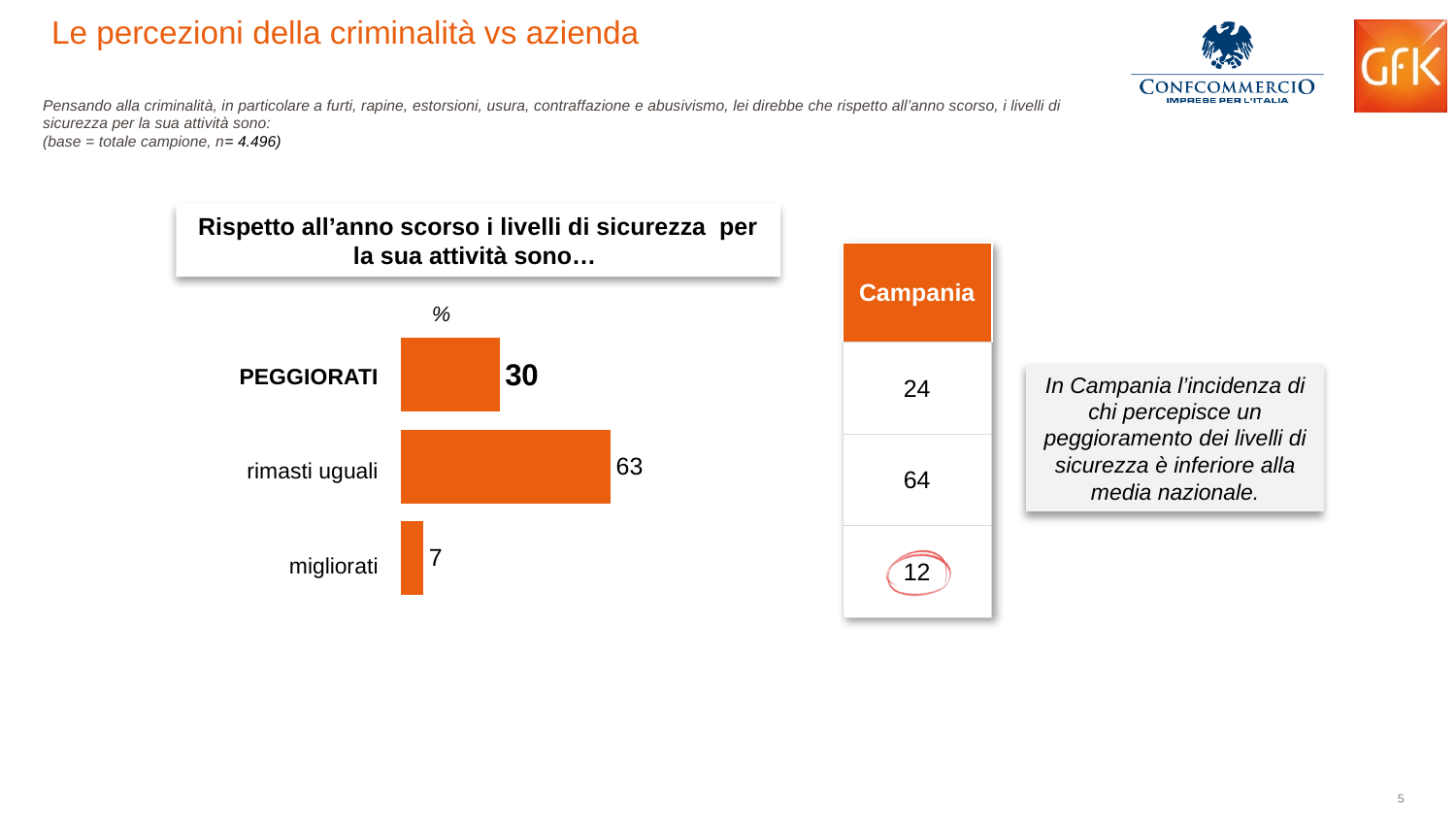
Which category has the highest value in the bar chart? rimasti uguali What kind of chart is shown on the slide? bar chart How many categories are shown in the bar chart? 3 What is the value for PEGGIORATI in the bar chart? 30 What is the difference between the values for 'rimasti uguali' and PEGGIORATI in the bar chart? 33 What is the value for 'rimasti uguali' in the bar chart? 63 What is the value for 'migliorati' in the bar chart? 7 What unit is indicated above the bars in the chart? % Which is larger in the bar chart, PEGGIORATI or migliorati? PEGGIORATI Which category has the lowest value in the bar chart? migliorati What is the title of the bar chart? Rispetto all'anno scorso i livelli di sicurezza per la sua attività sono… What is the total of the three values in the bar chart? 100